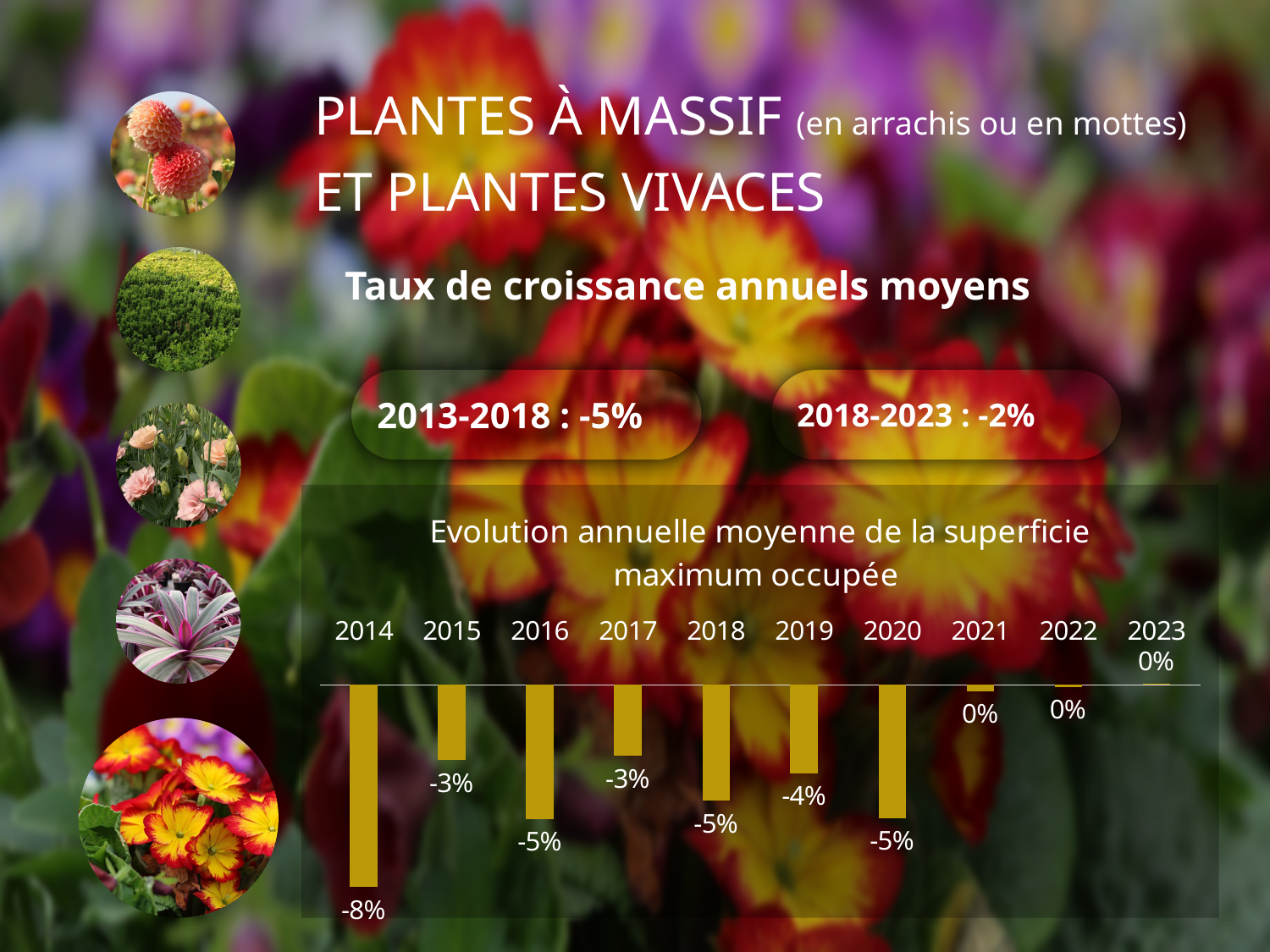
What is the value for 2022 in the chart? 0% Which is larger, the value for 2016 or the value for 2017? 2017 What is the title of the chart? Evolution annuelle moyenne de la superficie maximum occupée What is the value for 2014 in the chart? -8% What is the value for 2019 in the chart? -4% What is the difference between the values for 2014 and 2015? 5 percentage points Which year has the lowest value in the chart? 2014 What is the value for 2017 in the chart? -3% Do the values generally rise or fall from 2014 to 2023? Rise What kind of chart is shown on the slide? Bar chart How many years in the chart have a value of 0%? 3 How many years are shown on the x axis of the chart? 10